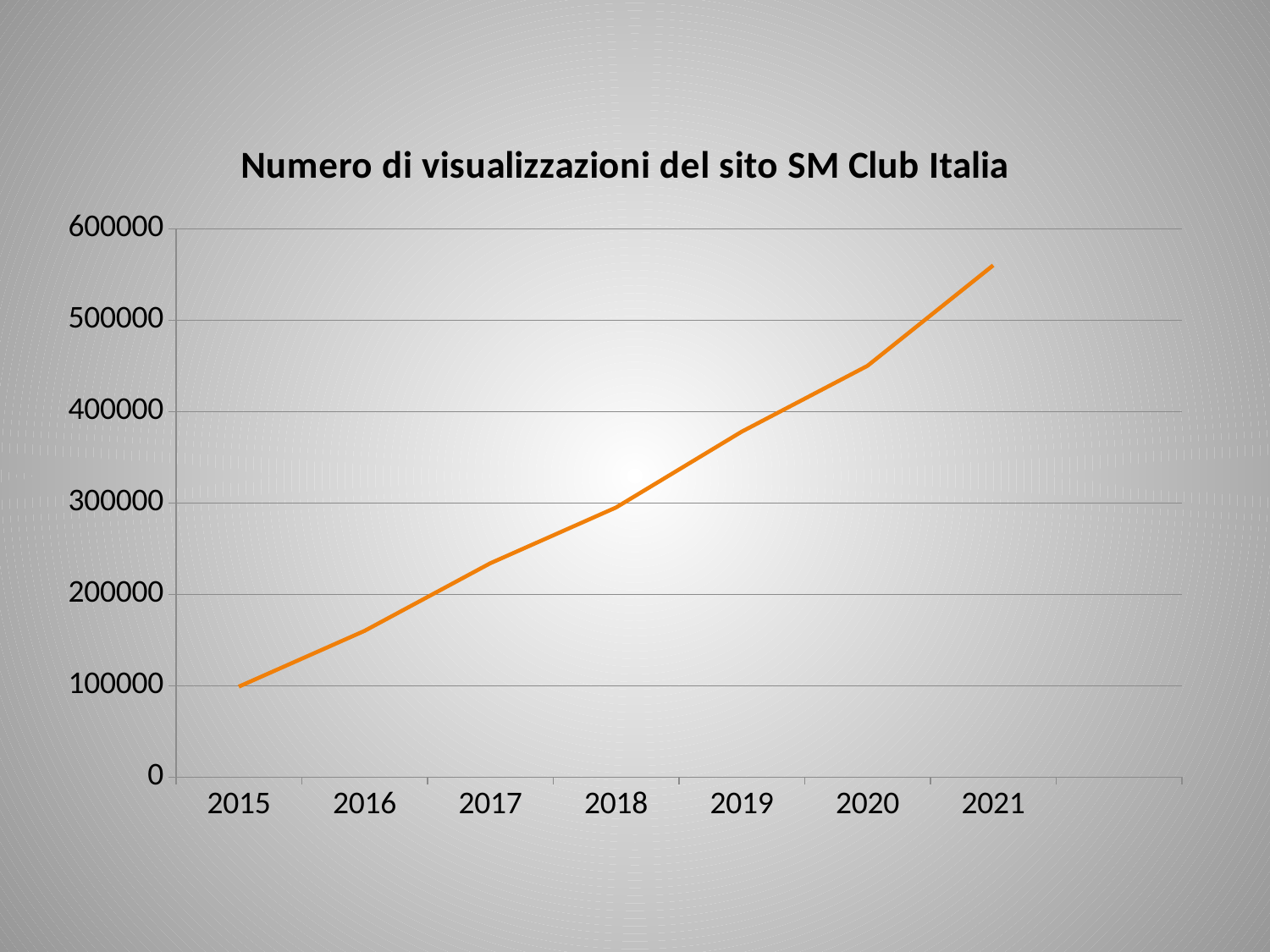
Which year has the lowest value? 2015 Is the value for 2020 greater or less than 400000? greater Is the value for 2021 greater or less than 500000? greater How many years are plotted on the x axis? 7 Which year has the highest value? 2021 Do the values rise or fall from 2015 to 2021? rise What type of chart is shown on the slide? line chart What is the title of the chart? Numero di visualizzazioni del sito SM Club Italia Which is larger, the value for 2019 or the value for 2017? 2019 Is the value for 2016 greater or less than 200000? less